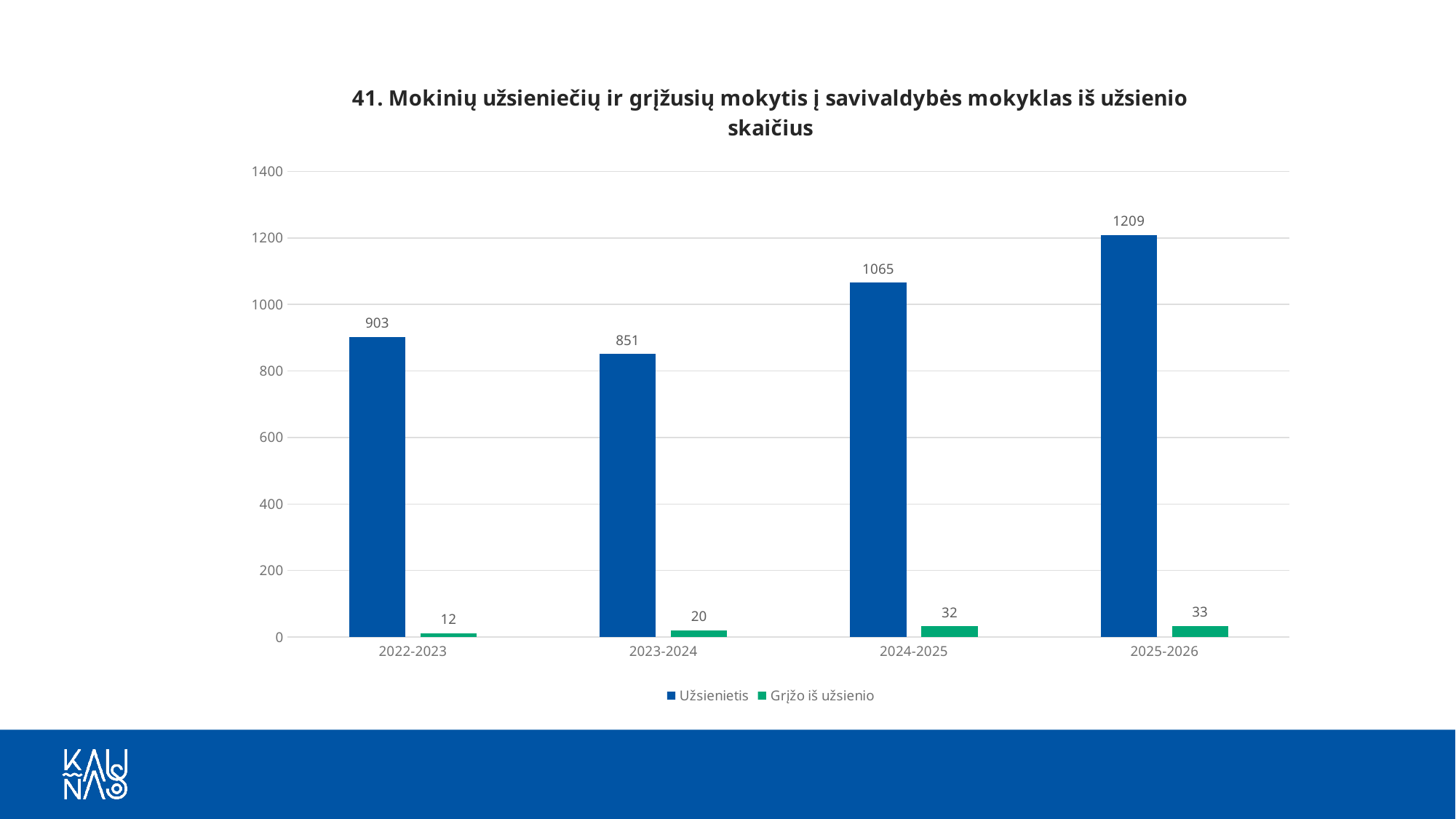
How many series does the legend list? 2 Is the Užsienietis value for 2024-2025 greater or less than 1000? greater In which school year is the Užsienietis value highest? 2025-2026 What is the value for Užsienietis in 2022-2023? 903 In which school year is the Grįžo iš užsienio value lowest? 2022-2023 Which is larger, the Užsienietis value for 2022-2023 or for 2023-2024? 2022-2023 Does the Grįžo iš užsienio series rise or fall from 2022-2023 to 2025-2026? rise What is the value for Užsienietis in 2025-2026? 1209 What is the difference between the Užsienietis values for 2025-2026 and 2024-2025? 144 What is the value for Grįžo iš užsienio in 2024-2025? 32 What kind of chart is shown on the slide? bar chart How many school years are shown on the x axis? 4